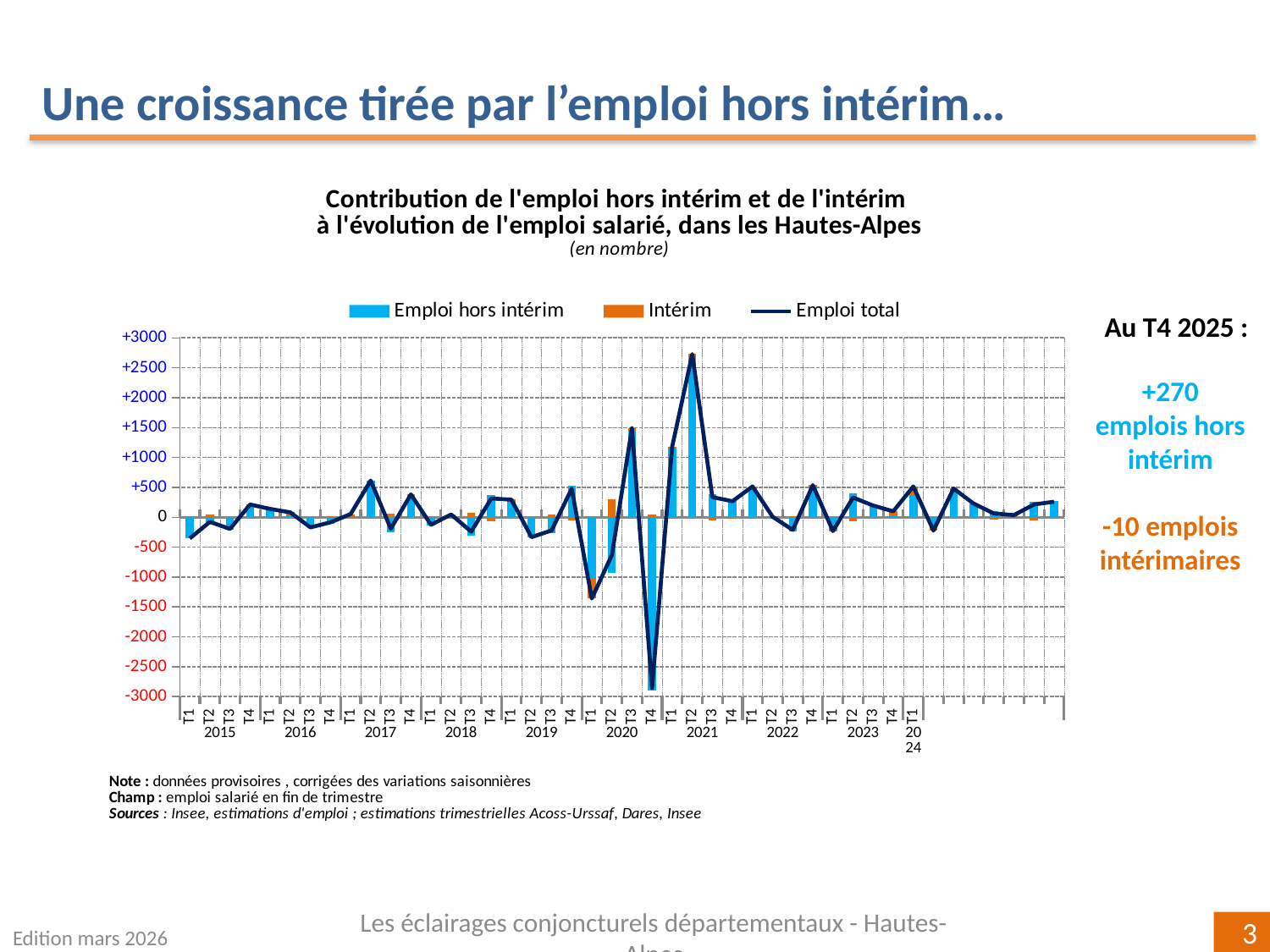
According to the slide, what is the contribution of emploi hors intérim at T4 2025? +270 Is the Emploi total value at T2 2021 greater or less than +2500? greater In which quarter does the Emploi total line reach its lowest value? T4 2020 Is the Emploi total value at T1 2020 greater or less than -1000? less According to the slide, what is the contribution of intérim at T4 2025? -10 In which quarter does the Emploi total line reach its highest value? T2 2021 How many series does the chart legend list? 3 Which quarter has the larger Emploi total value, T3 2020 or T4 2020? T3 2020 What kind of chart is shown on the slide? A combined bar and line chart What are the three series listed in the chart legend? Emploi hors intérim, Intérim, Emploi total What colour are the Intérim bars in the chart? Orange Is the Emploi total value at T4 2020 greater or less than -2500? less